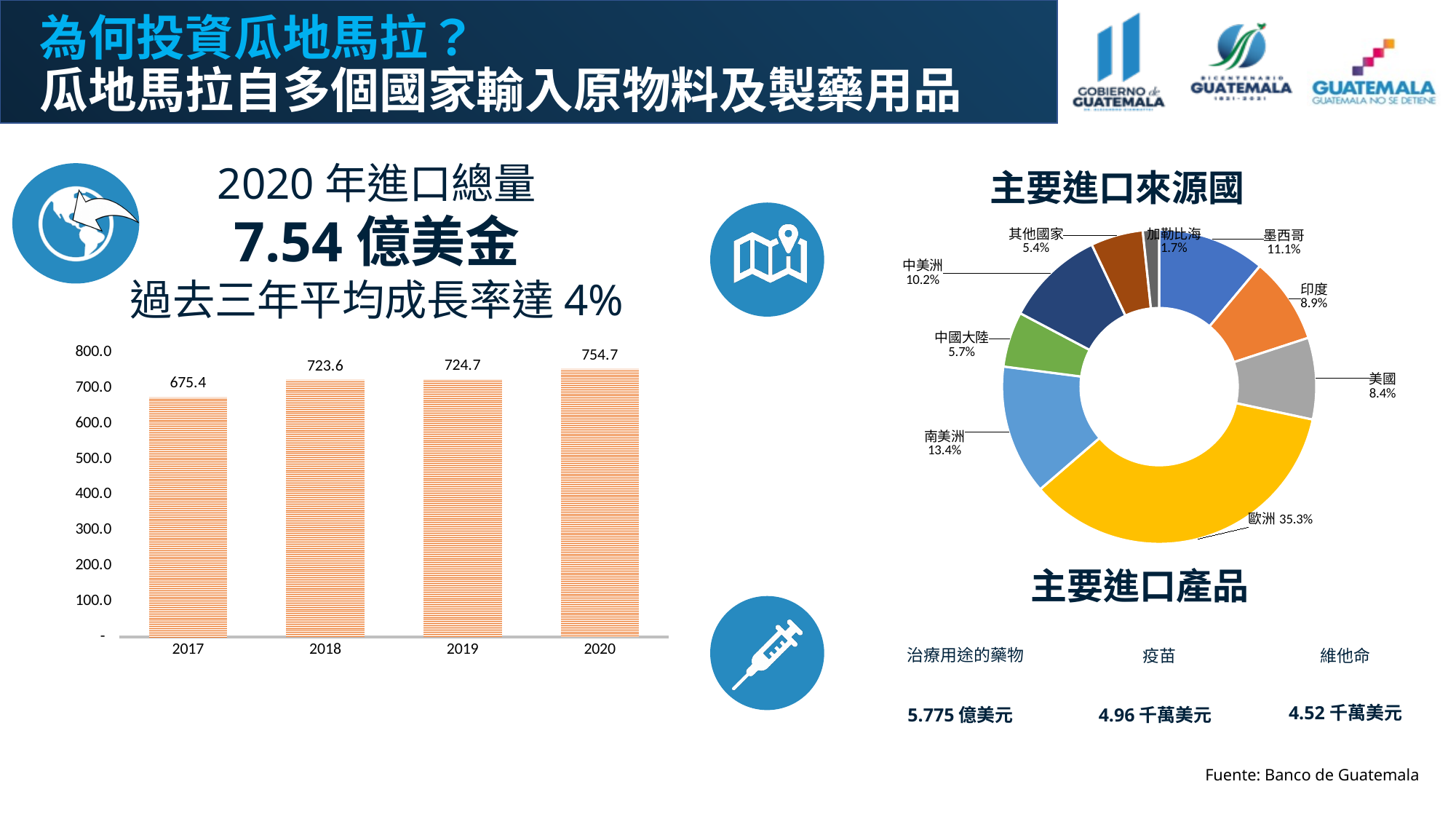
In the doughnut chart titled 主要進口來源國, which category has the smallest share? 加勒比海 In the bar chart on the left, do the values rise or fall from 2017 to 2020? rise In the doughnut chart titled 主要進口來源國, what share does 歐洲 have? 35.3% In the bar chart on the left, what is the value for 2020? 754.7 What kind of chart is the chart on the left? bar chart In the bar chart on the left, what is the value for 2017? 675.4 In the doughnut chart titled 主要進口來源國, how many categories are shown? 9 In the bar chart on the left, which year has the lowest value? 2017 In the doughnut chart titled 主要進口來源國, which is larger, 南美洲 or 墨西哥? 南美洲 In the bar chart on the left, what is the difference between the 2020 value and the 2017 value? 79.3 In the bar chart on the left, how many years are shown? 4 In the bar chart on the left, which year has the highest value? 2020